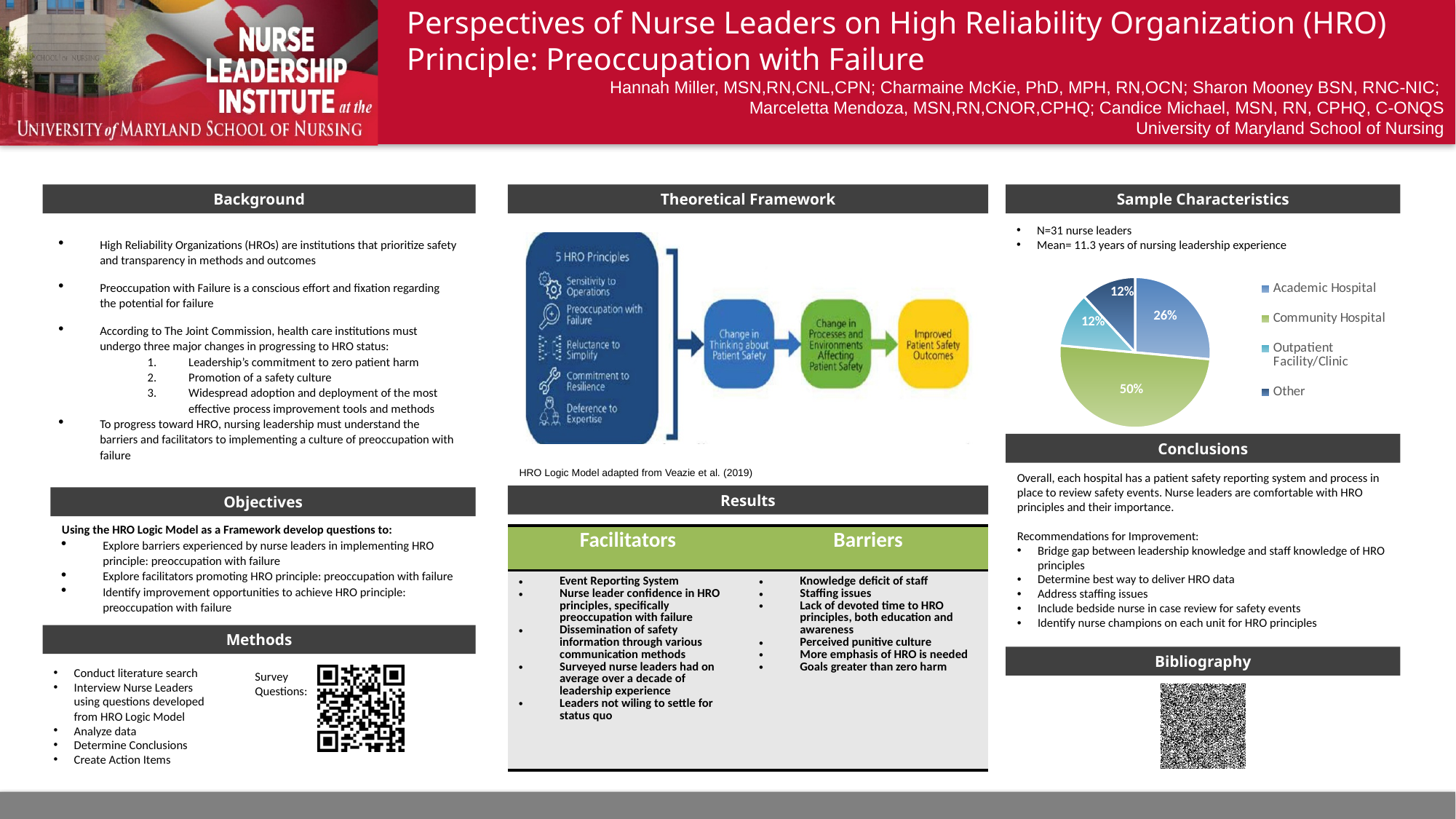
In the pie chart, what percentage of nurse leaders are from a Community Hospital? 50% In the pie chart, which is larger: Academic Hospital or Outpatient Facility/Clinic? Academic Hospital In the pie chart, what percentage is shown for Outpatient Facility/Clinic? 12% What colour is the Community Hospital slice in the pie chart? green How many categories does the legend of the pie chart list? 4 What share of the pie does the Community Hospital slice represent? 50% In the pie chart, what percentage of nurse leaders are from an Academic Hospital? 26% Which category has the largest slice in the pie chart? Community Hospital In the pie chart, what percentage is shown for the Other category? 12% What is the difference in percentage points between Community Hospital and Academic Hospital in the pie chart? 24 How many slices does the pie chart have? 4 What type of chart is shown in the Sample Characteristics section? pie chart